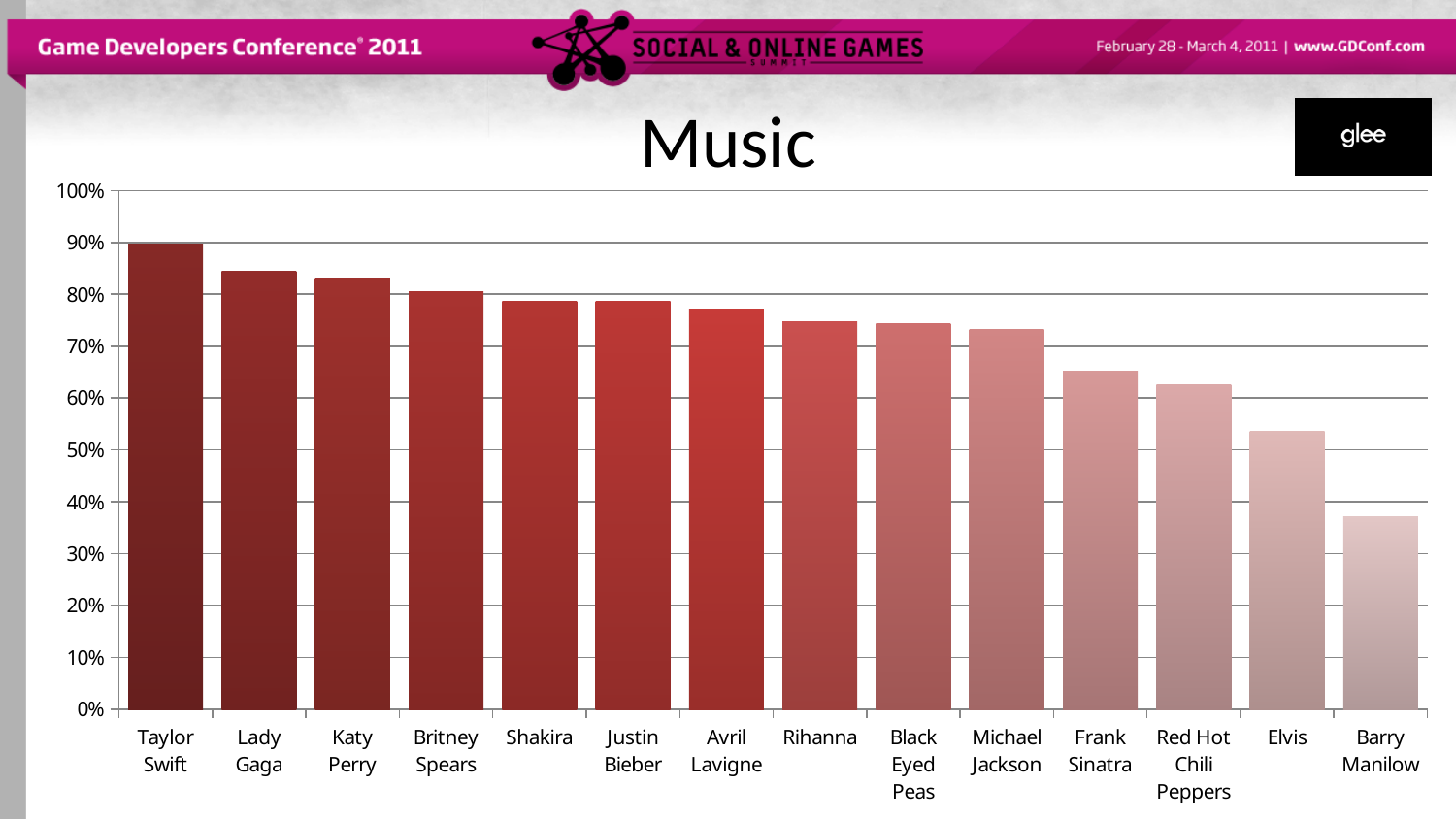
Do the values rise or fall moving from left to right along the x axis? fall Which artist has the highest value in the chart? Taylor Swift Is the value for Frank Sinatra greater or less than 60%? greater What is the title of the chart? Music Is the value for Michael Jackson greater or less than 70%? greater Which is larger, the value for Elvis or the value for Frank Sinatra? Frank Sinatra What kind of chart is shown on the slide? bar chart Is the value for Barry Manilow greater or less than 40%? less How many artists are shown on the x axis of the chart? 14 Which artist has the lowest value in the chart? Barry Manilow